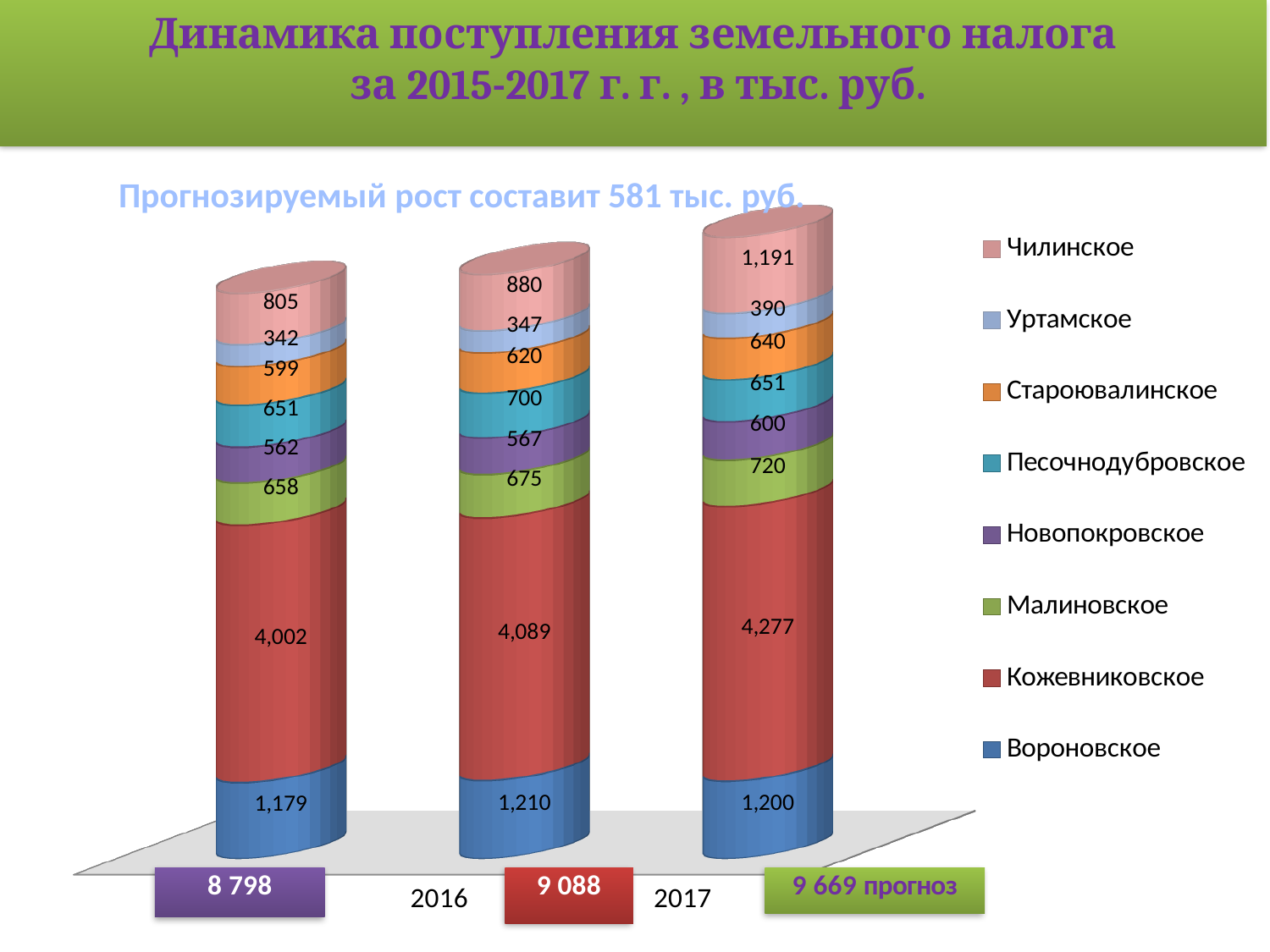
What is the value for Чилинское in 2016? 880 How many series does the legend list? 8 Which is larger: Малиновское in 2017 or Песочнодубровское in 2017? Малиновское in 2017 How many bars (years) are plotted in the chart? 3 What is the value for Кожевниковское in 2017? 4,277 What type of chart is shown on the slide? Stacked bar chart What is the total of the 2017 stacked bar, as shown on the slide? 9 669 Which series has the largest value in the 2016 bar? Кожевниковское Which series has the smallest value in the 2017 bar? Уртамское What is the value for Вороновское in the first (2015) bar? 1,179 What is the difference between the Кожевниковское values for 2017 and 2016? 188 What is the value for Уртамское in 2017? 390